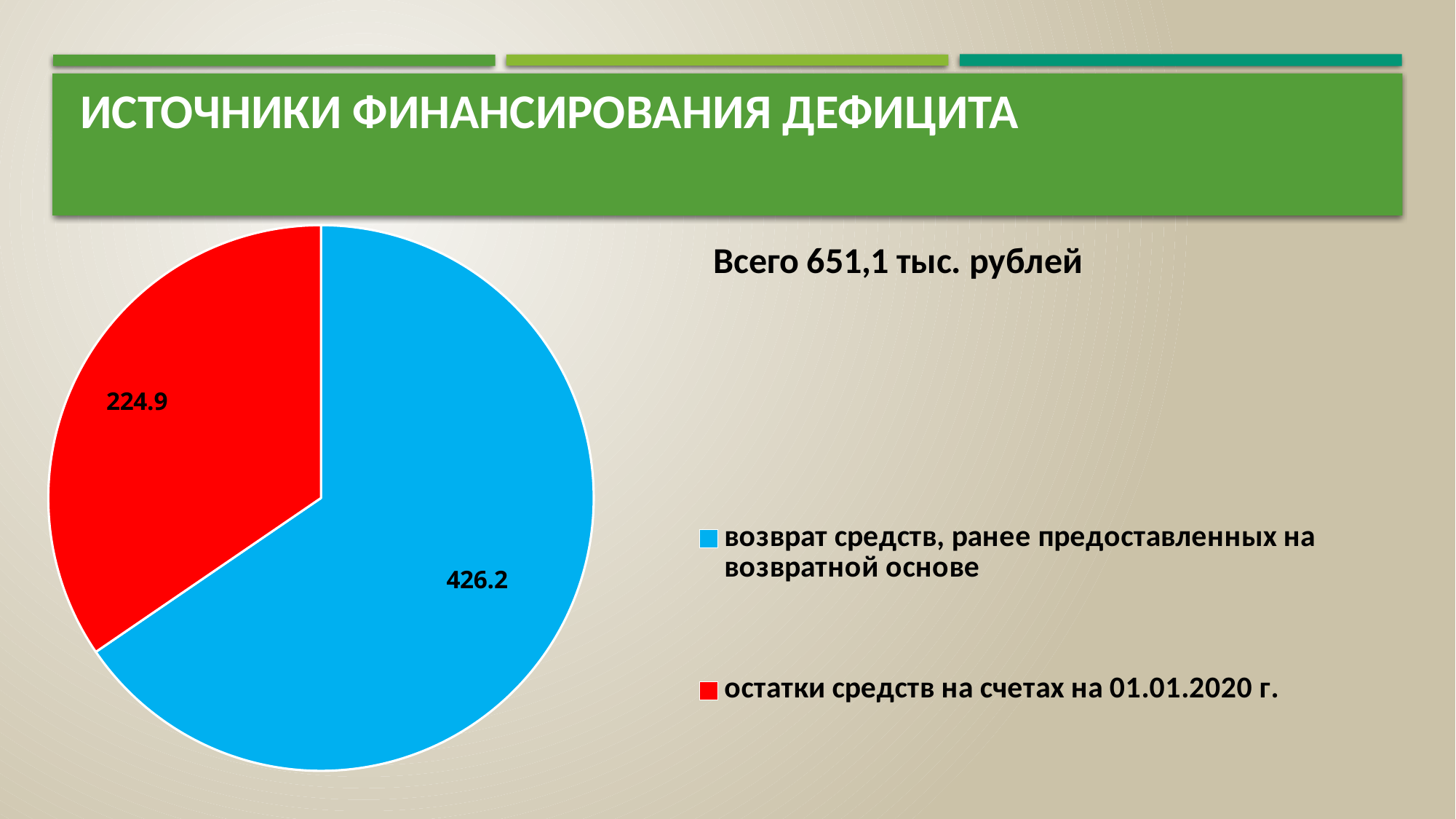
Which is larger: the value for "возврат средств, ранее предоставленных на возвратной основе" or the value for "остатки средств на счетах на 01.01.2020 г."? возврат средств, ранее предоставленных на возвратной основе What is the difference between the value for "возврат средств, ранее предоставленных на возвратной основе" and the value for "остатки средств на счетах на 01.01.2020 г."? 201.3 What is the value for "остатки средств на счетах на 01.01.2020 г."? 224.9 How many slices does the pie chart have? 2 What is the value for "возврат средств, ранее предоставленных на возвратной основе"? 426.2 What share of the pie does "возврат средств, ранее предоставленных на возвратной основе" represent, to one decimal place? 65.5% Which category has the largest slice of the pie? возврат средств, ранее предоставленных на возвратной основе What is the total of the two slices in the pie chart? 651.1 What colour is the slice for "остатки средств на счетах на 01.01.2020 г."? red How many entries does the legend list? 2 Which category has the smallest slice of the pie? остатки средств на счетах на 01.01.2020 г. What kind of chart is shown on the slide? pie chart